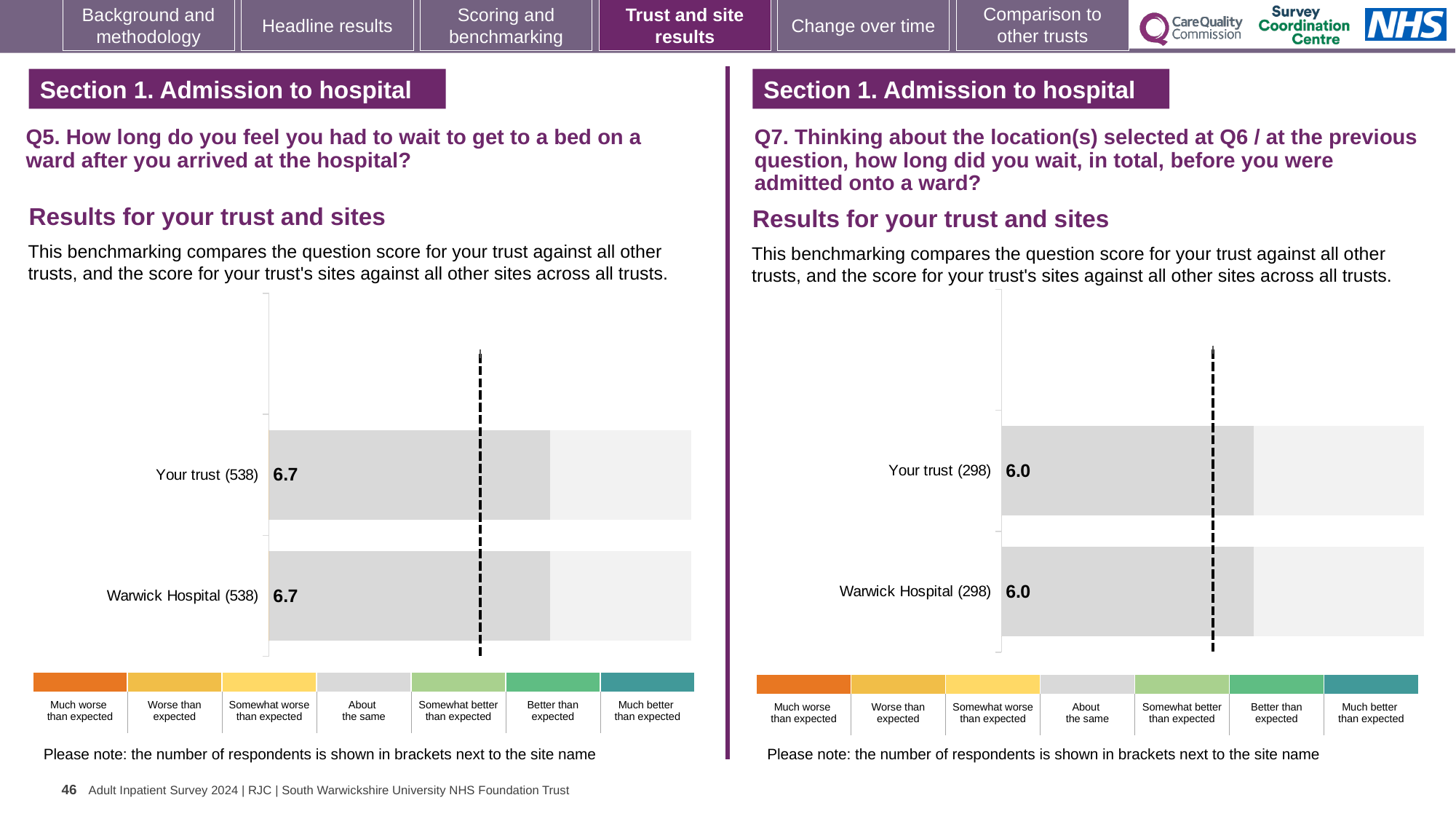
On the left chart (Q5), what is the score for Your trust? 6.7 Is the Your trust score on the left chart (Q5) larger or smaller than the Your trust score on the right chart (Q7)? Larger On the right chart (Q7), what is the difference between the Your trust score and the Warwick Hospital score? 0.0 On the left chart (Q5), how many respondents are shown in brackets next to Warwick Hospital? 538 How many bars are plotted on the right chart (Q7)? 2 On the left chart (Q5), what is the score for Warwick Hospital? 6.7 How many bars are plotted on the left chart (Q5)? 2 What kind of chart is used on the left (Q5)? Bar chart On the right chart (Q7), what is the score for Warwick Hospital? 6.0 On the right chart (Q7), what is the score for Your trust? 6.0 On the left chart (Q5), what is the difference between the Your trust score and the Warwick Hospital score? 0.0 On the right chart (Q7), how many respondents are shown in brackets next to Your trust? 298